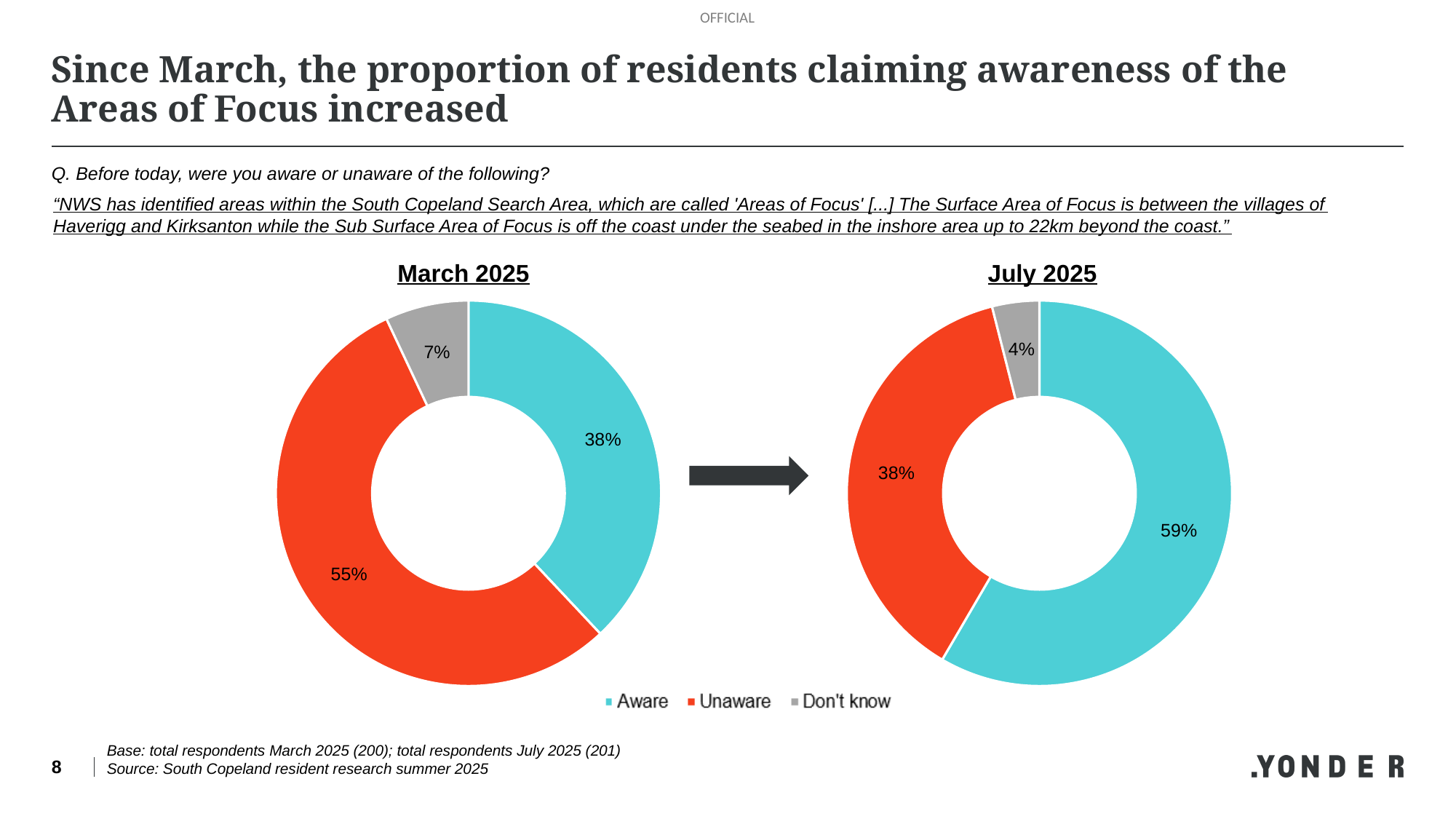
In the July 2025 chart, what percentage of residents were Aware? 59% In the July 2025 chart, what percentage answered Don't know? 4% In the March 2025 chart, which category has the largest share? Unaware In the July 2025 chart, what percentage of residents were Unaware? 38% How many categories does the legend list? 3 What kind of chart is used for March 2025 and July 2025? Doughnut (pie) chart What is the difference between the Aware share in July 2025 and the Aware share in March 2025? 21 percentage points In the July 2025 chart, which category has the smallest share? Don't know In the March 2025 chart, what percentage answered Don't know? 7% In the March 2025 chart, what percentage of residents were Unaware? 55% In the March 2025 chart, what percentage of residents were Aware? 38% In the July 2025 chart, which is larger: the Aware share or the Unaware share? Aware